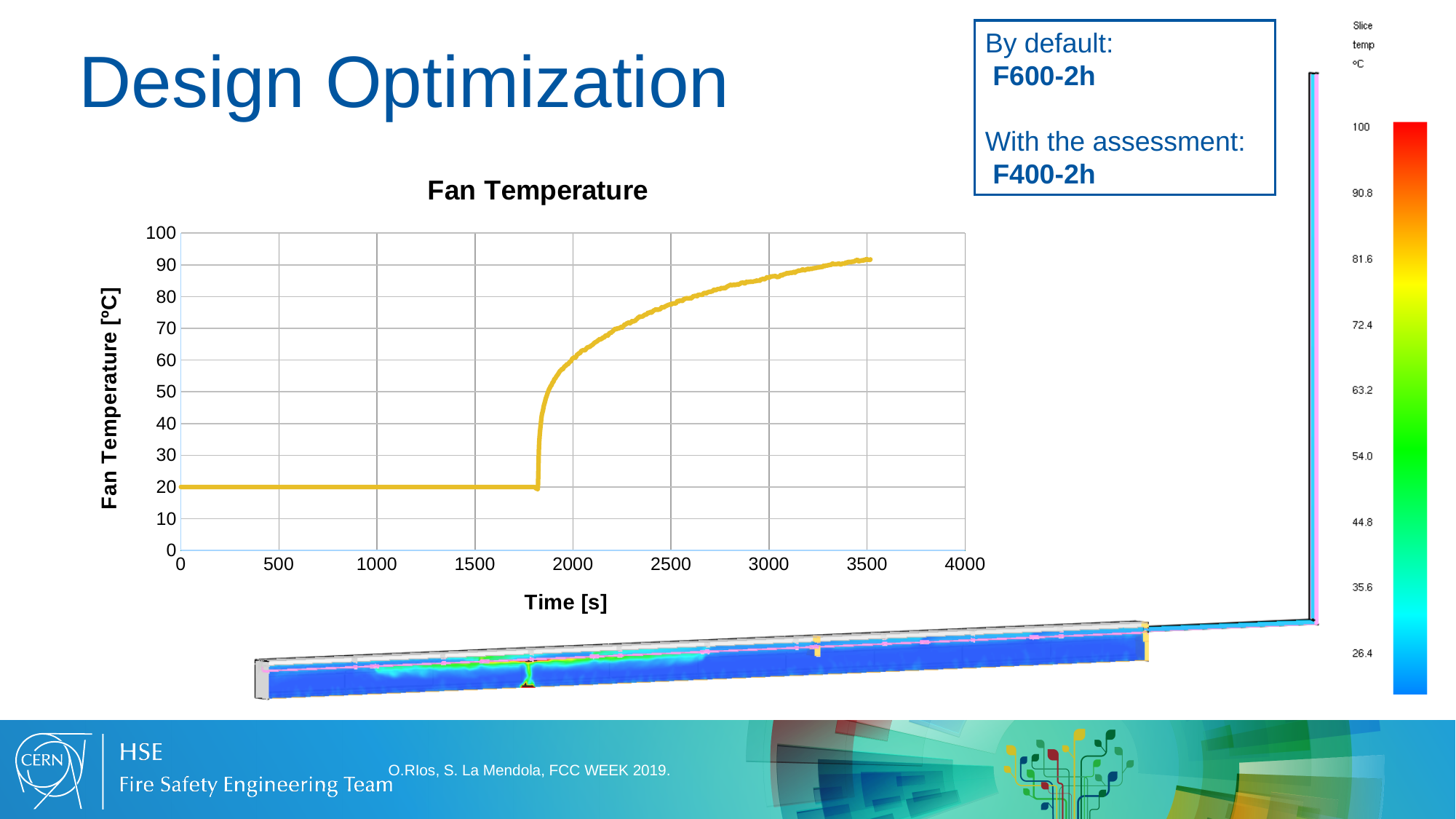
What is the maximum value shown on the y axis of the Fan Temperature chart? 100 In the Fan Temperature chart, what is the fan temperature at 500 s? 20 What is the title of the chart on the slide? Fan Temperature In the Fan Temperature chart, is the fan temperature at 3500 s greater or less than 100? less What is the label of the x axis of the Fan Temperature chart? Time [s] In the Fan Temperature chart, is the fan temperature at 3000 s greater or less than 80? greater In the Fan Temperature chart, is the fan temperature at 1500 s greater or less than 30? less What kind of chart is the Fan Temperature chart? line chart In the Fan Temperature chart, what is the fan temperature at 1000 s? 20 In the Fan Temperature chart, does the fan temperature rise or fall between 2000 s and 3500 s? rise In the Fan Temperature chart, which is larger: the fan temperature at 1000 s or at 3000 s? 3000 s